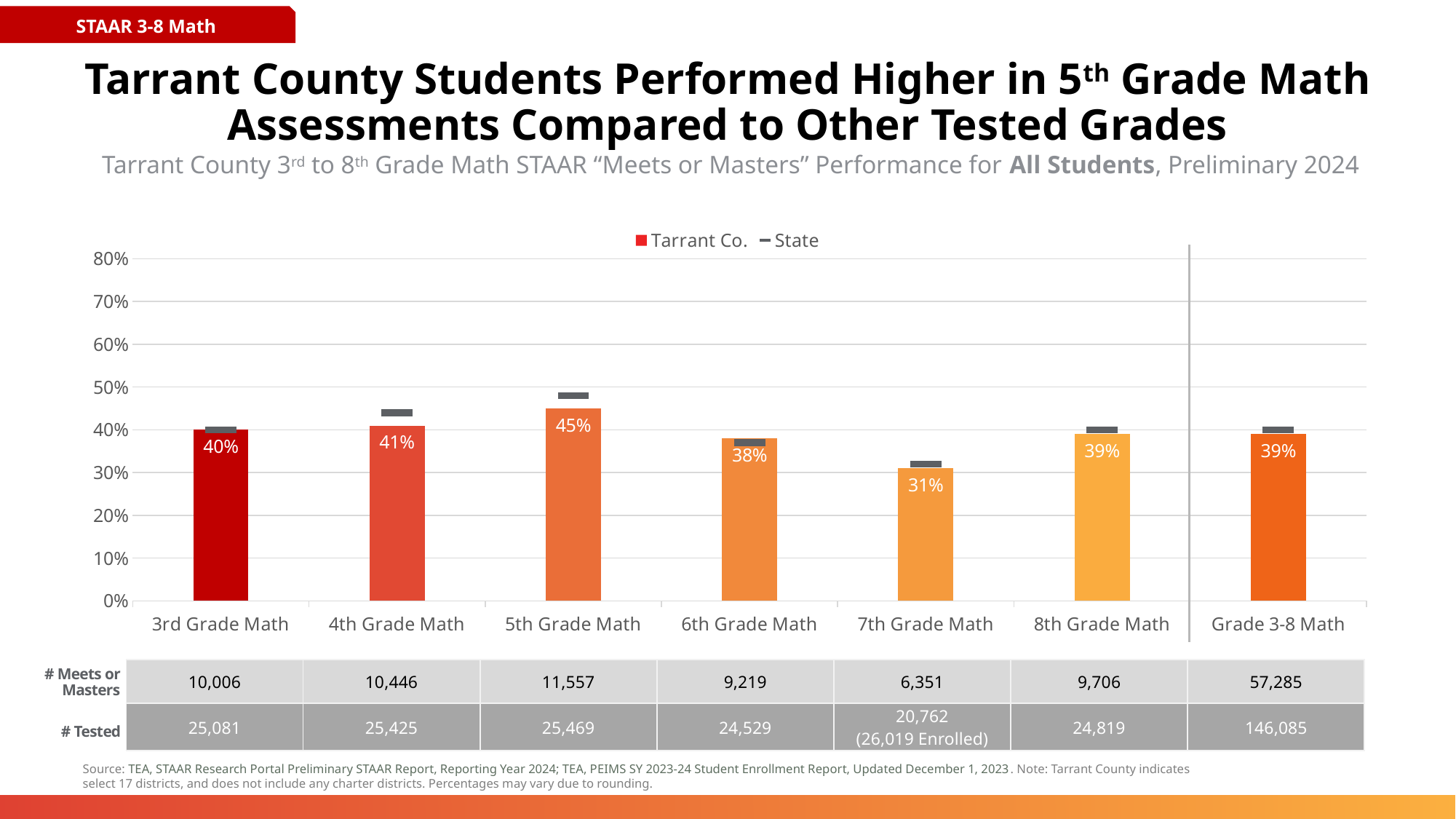
What is the Tarrant Co. value for 7th Grade Math? 31% Which grade has the highest Tarrant Co. value? 5th Grade Math How many series does the legend list? 2 Which grade has the lowest Tarrant Co. value? 7th Grade Math What kind of chart is shown on the slide? bar chart Which is larger, the Tarrant Co. value for 4th Grade Math or for 8th Grade Math? 4th Grade Math How many categories are shown on the x axis of the chart? 7 What is the difference between the Tarrant Co. values for 5th Grade Math and 7th Grade Math? 14 percentage points What is the Tarrant Co. value for 5th Grade Math? 45% What is the Tarrant Co. value for Grade 3-8 Math? 39% What are the two entries in the chart legend? Tarrant Co. and State Is the State value for 5th Grade Math greater or less than 50%? less